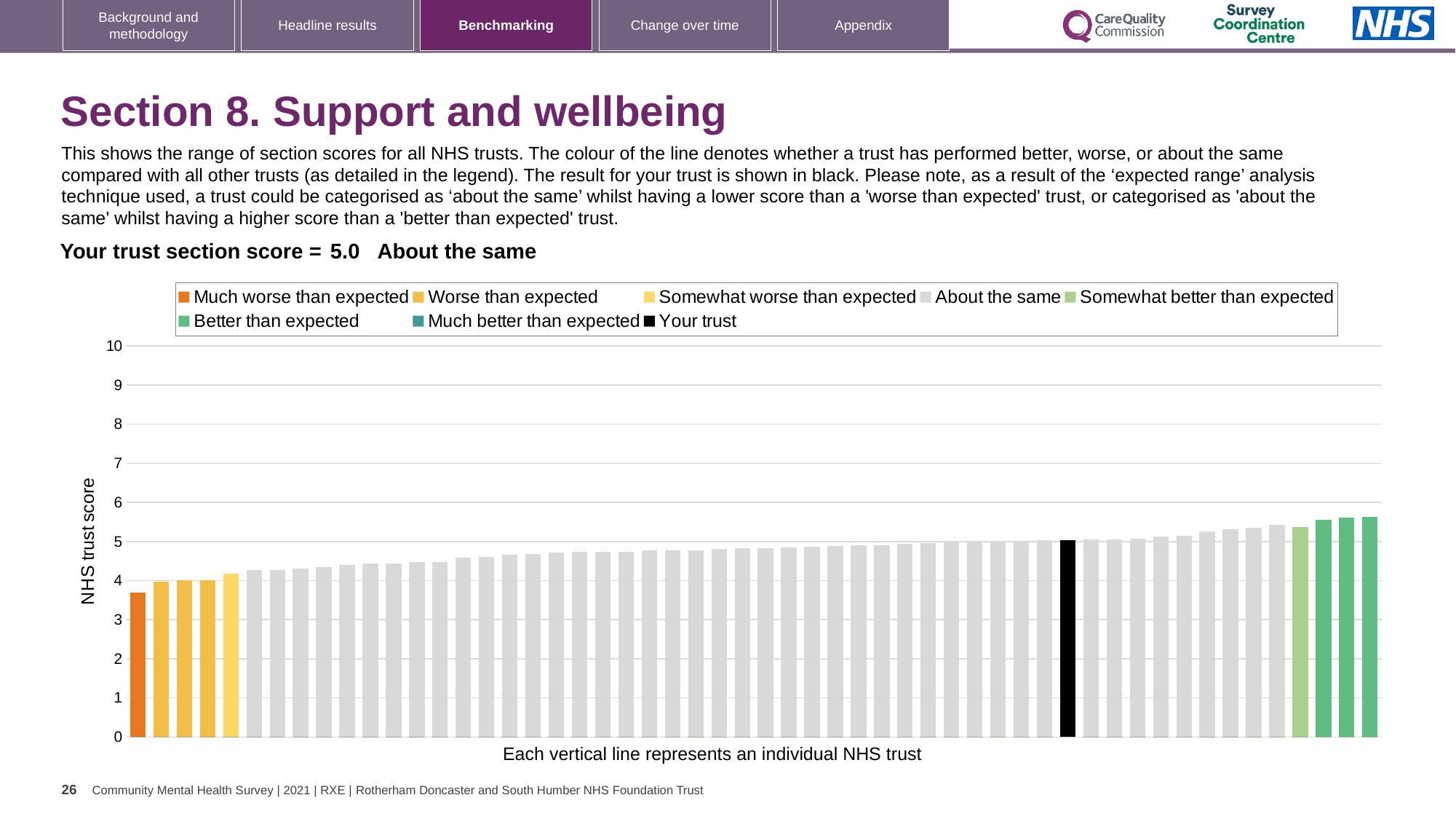
How many bars are coloured as 'Much worse than expected'? 1 Is the value of the lowest (orange) bar greater or less than 4? less What is the section score for your trust shown on the slide? 5.0 Is the value of the highest bar on the chart greater or less than 5? greater Is the bar for your trust (black) higher or lower than the orange bar? Higher Which legend category does the lowest bar on the chart belong to? Much worse than expected What is the label on the vertical axis of the chart? NHS trust score Do the bar values rise or fall from left to right along the x axis? Rise How many entries does the chart legend list? 8 How many bars are coloured as 'Better than expected'? 3 What kind of chart is shown on the slide? Bar chart Which legend category does the highest bar on the chart belong to? Better than expected